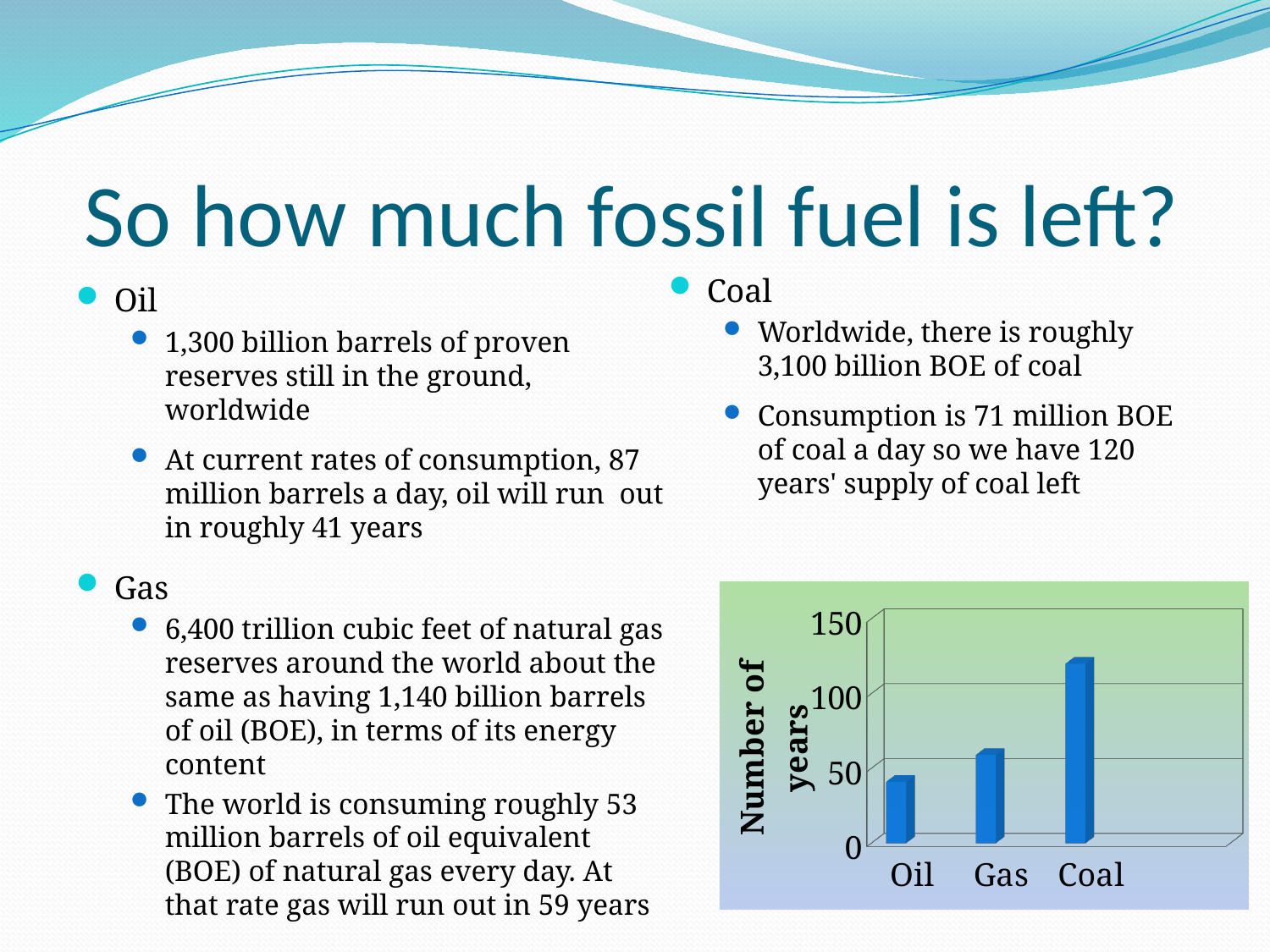
Is the value for Gas greater or less than 100? less Is the value for Coal greater or less than 100? greater Which category has the lowest bar on the chart? Oil Which category has the highest bar on the chart? Coal What is the label on the vertical axis of the chart? Number of years Is the value for Coal greater or less than 150? less Do the bar values rise or fall from left to right across the chart? rise How many categories are plotted on the chart? 3 What kind of chart is shown on the slide? bar chart Which is larger on the chart, the value for Gas or the value for Oil? Gas